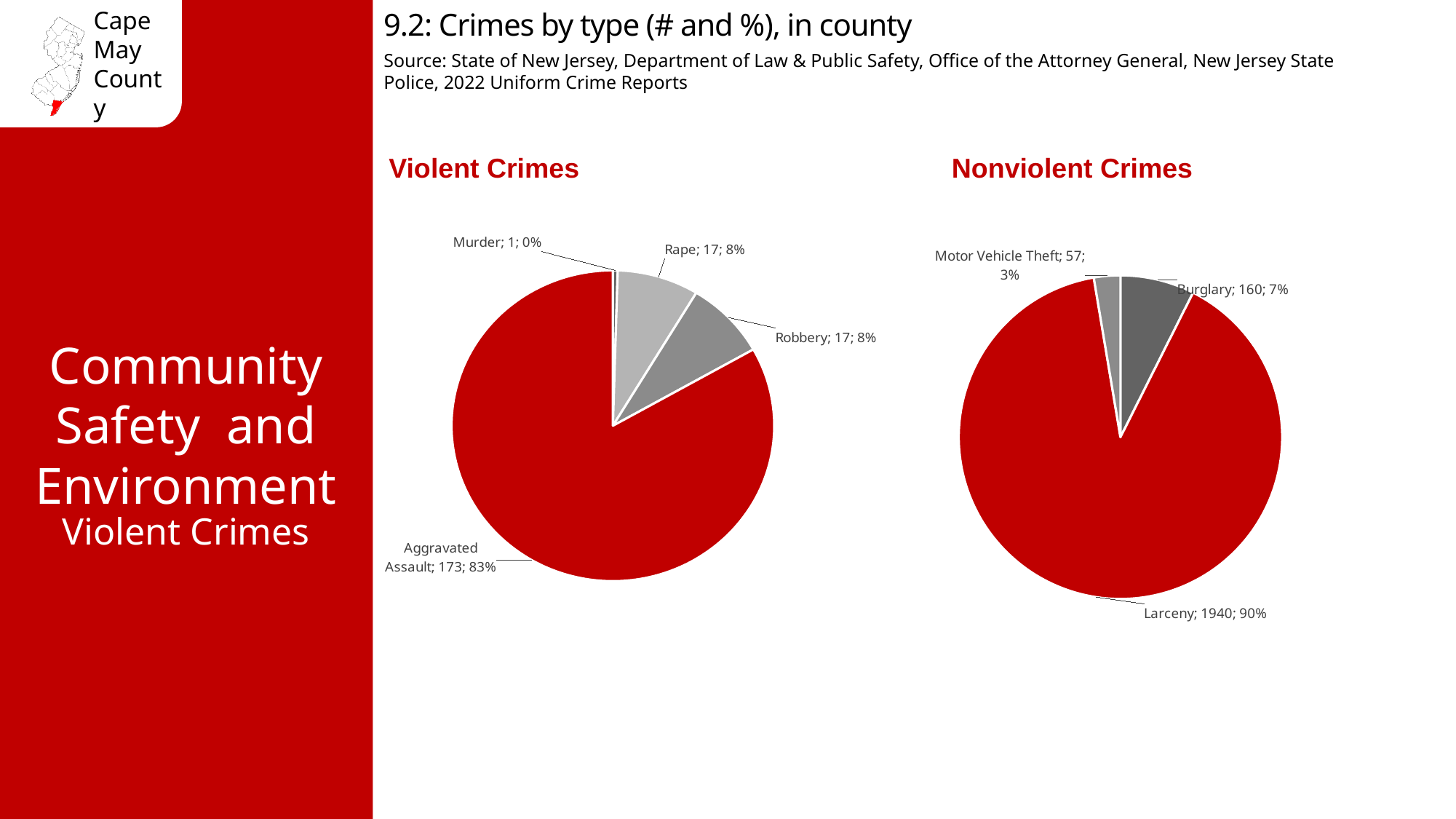
In the Violent Crimes chart, how many aggravated assaults are shown? 173 In the Violent Crimes chart, what share of the pie is Rape? 8% In the Violent Crimes chart, how many categories are shown? 4 In the Violent Crimes chart, what is the difference between the number of aggravated assaults and the number of robberies? 156 In the Nonviolent Crimes chart, which category has the smallest slice? Motor Vehicle Theft In the Violent Crimes chart, which category has the smallest slice? Murder In the Nonviolent Crimes chart, how many larcenies are shown? 1940 In the Nonviolent Crimes chart, which is larger, Burglary or Motor Vehicle Theft? Burglary In the Nonviolent Crimes chart, what share of the pie is Burglary? 7% What type of chart is used for the Nonviolent Crimes chart? Pie chart In the Violent Crimes chart, which category has the largest slice? Aggravated Assault In the Nonviolent Crimes chart, what is the difference between the number of burglaries and motor vehicle thefts? 103